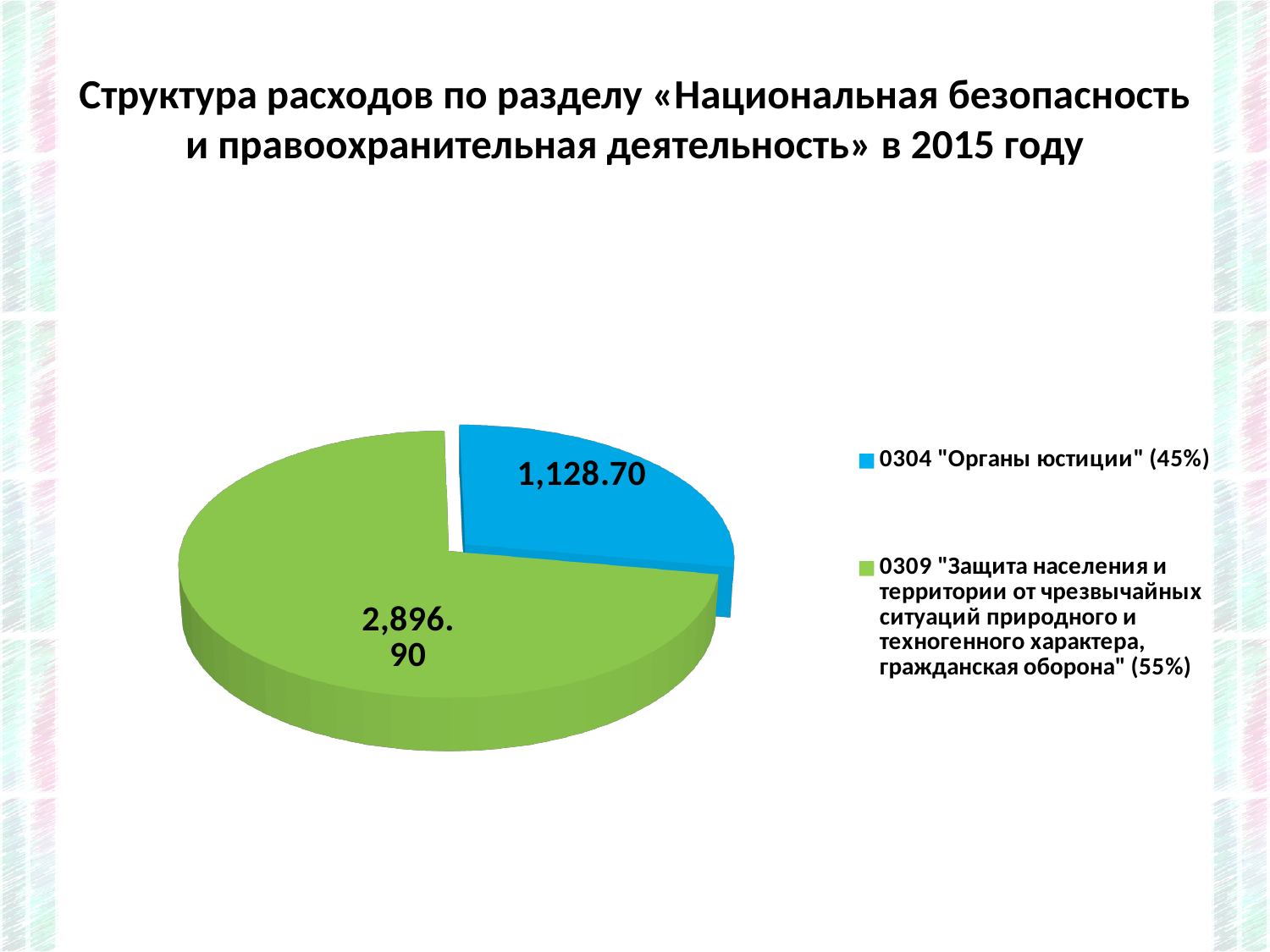
What percentage is shown in the legend next to 0304 "Органы юстиции"? 45% Which is larger: the value for 0304 "Органы юстиции" or the value for 0309 "Защита населения..."? 0309 "Защита населения..." How many slices does the pie chart have? 2 Which slice of the pie chart has the largest value? 0309 "Защита населения и территории от чрезвычайных ситуаций природного и техногенного характера, гражданская оборона" What kind of chart is shown on the slide? Pie chart What is the value shown for the slice 0309 "Защита населения и территории от чрезвычайных ситуаций природного и техногенного характера, гражданская оборона"? 2,896.90 What is the value shown for the slice 0304 "Органы юстиции"? 1,128.70 What is the total of the two values shown on the pie chart? 4,025.60 What colour is the slice for 0309 "Защита населения..."? Green What is the difference between the values of the 0309 slice and the 0304 slice? 1,768.20 How many entries does the legend list? 2 Which slice of the pie chart has the smallest value? 0304 "Органы юстиции"